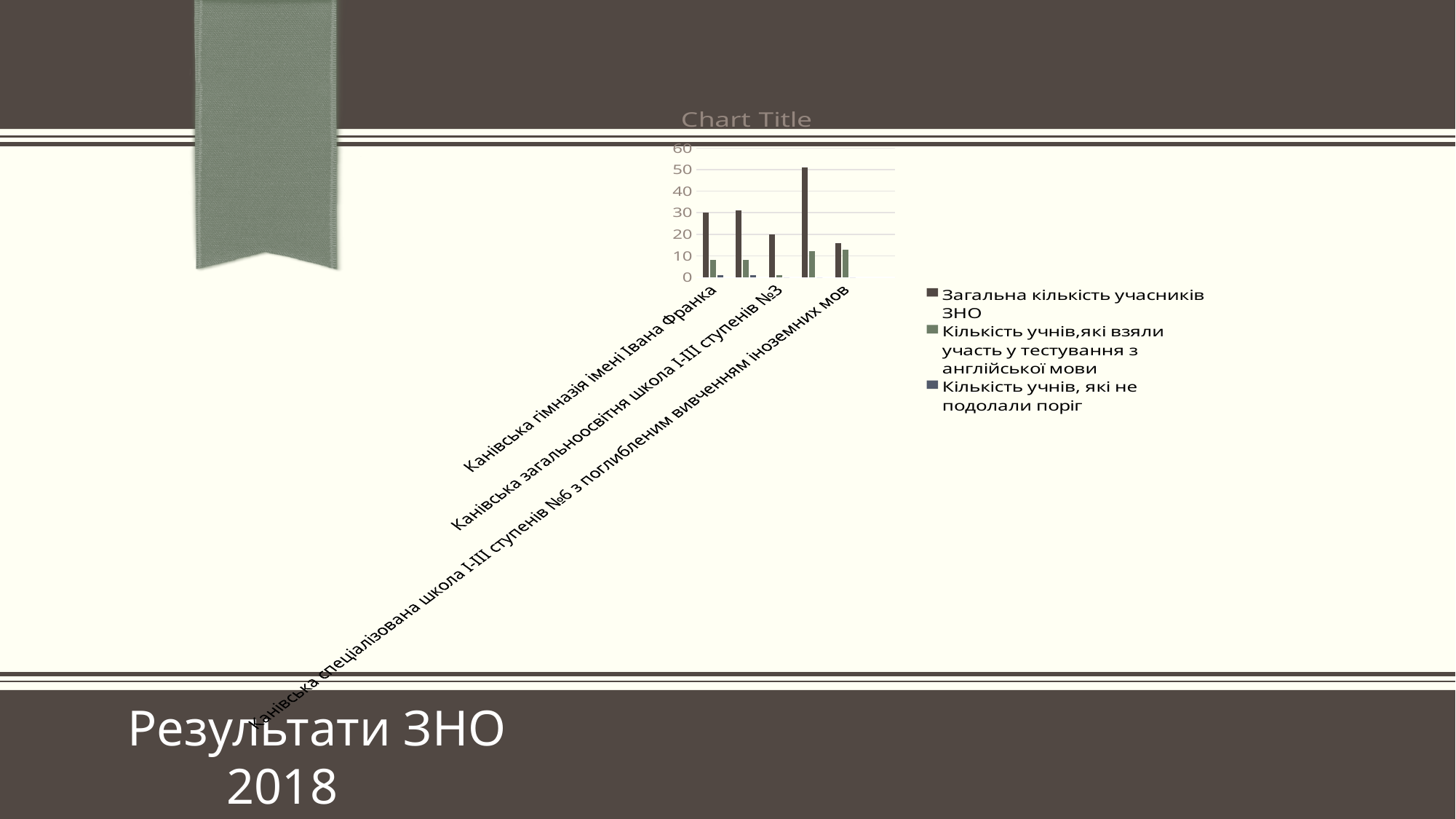
How many series does the chart's legend list? 3 Is the value of Кількість учнів,які взяли участь у тестування з англійської мови for Канівська гімназія імені Івана Франка greater or less than 20? less Which has the larger value of Загальна кількість учасників ЗНО: Канівська гімназія імені Івана Франка or Канівська спеціалізована школа I-III ступенів №6 з поглибленим вивченням іноземних мов? Канівська гімназія імені Івана Франка For Канівська гімназія імені Івана Франка, which series has the highest bar? Загальна кількість учасників ЗНО Is the value of Загальна кількість учасників ЗНО for Канівська спеціалізована школа I-III ступенів №6 з поглибленим вивченням іноземних мов greater or less than 30? less What is the title shown above the chart? Chart Title Is the value of Загальна кількість учасників ЗНО for Канівська гімназія імені Івана Франка greater or less than 20? greater What is the first entry in the chart's legend? Загальна кількість учасників ЗНО For Канівська гімназія імені Івана Франка, which series has the lowest bar? Кількість учнів, які не подолали поріг What kind of chart is shown on the slide? bar chart